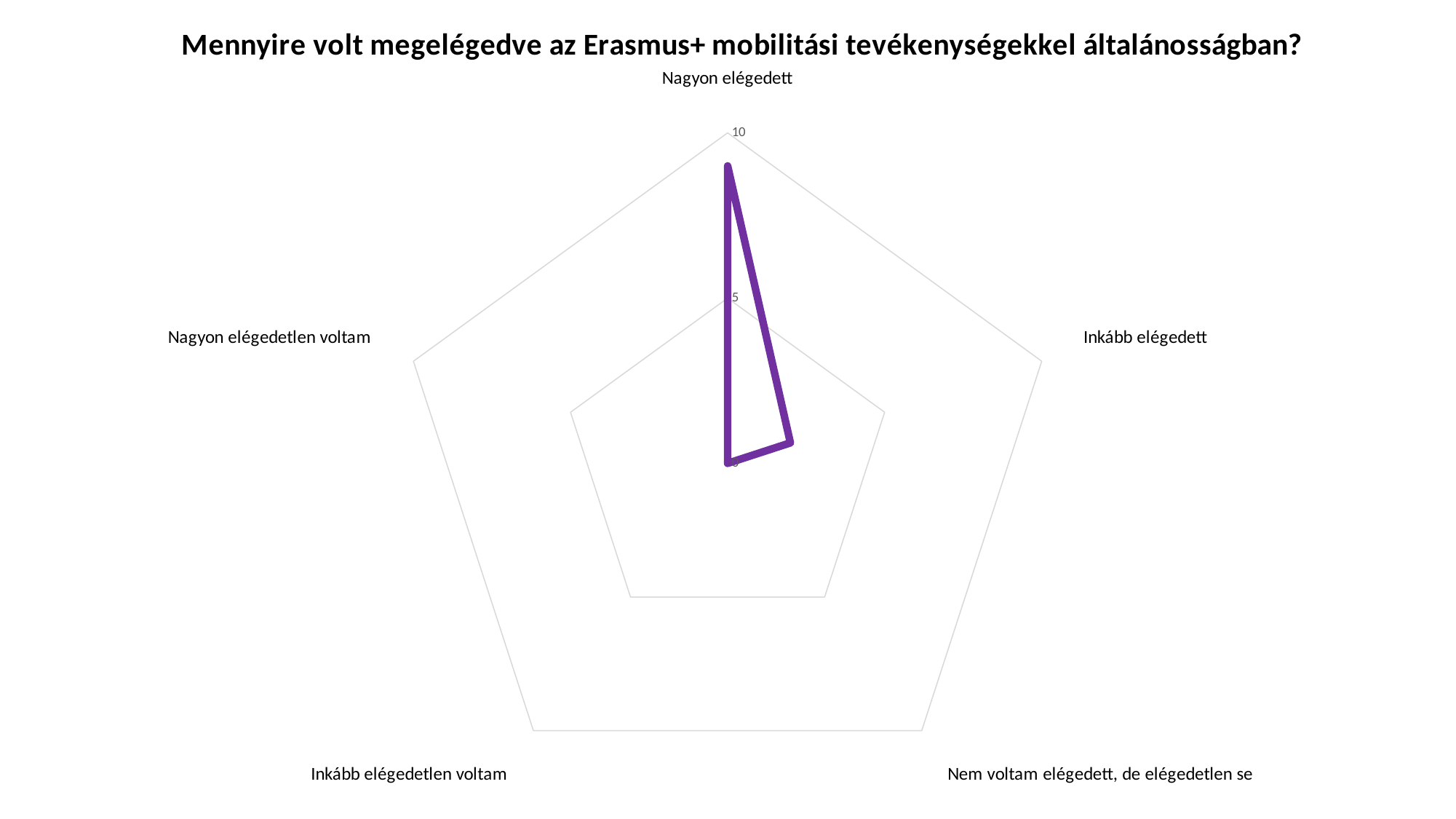
What kind of chart is shown on the slide? radar chart Is the value for Nagyon elégedett greater or less than 5? greater Is the value for Inkább elégedett greater or less than 5? less What is the title of the chart? Mennyire volt megelégedve az Erasmus+ mobilitási tevékenységekkel általánosságban? How many categories does the radar chart have? 5 Which category has the highest value in the chart? Nagyon elégedett Which is larger, the value for Inkább elégedett or the value for Nem voltam elégedett, de elégedetlen se? Inkább elégedett Is the value for Nagyon elégedetlen voltam greater or less than 5? less Which is larger, the value for Nagyon elégedett or the value for Inkább elégedett? Nagyon elégedett What is the highest tick value shown on the chart's axis? 10